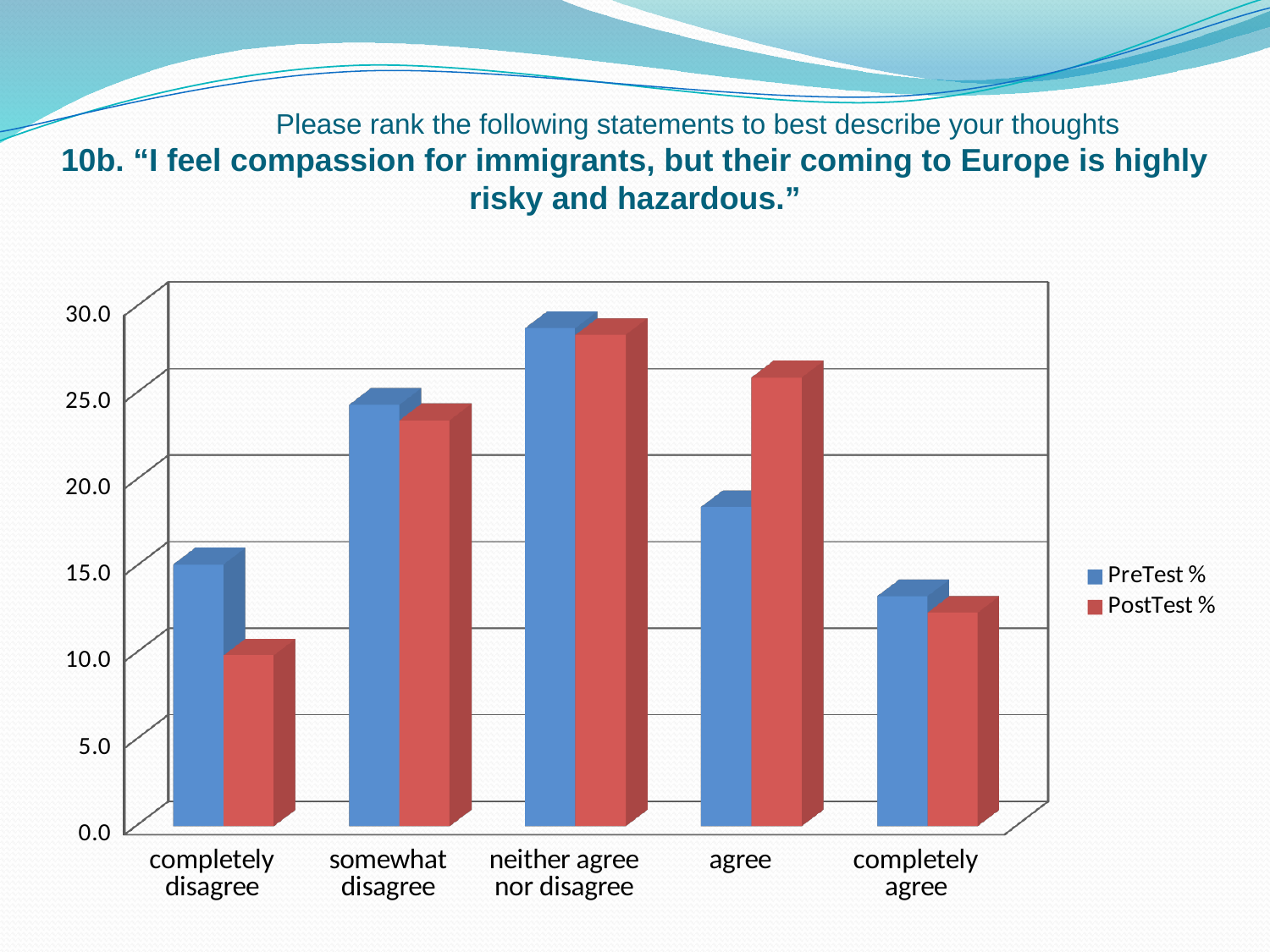
Is the PostTest % value for 'agree' greater or less than 20.0? greater Which category has the highest PreTest % value? neither agree nor disagree Is the PostTest % value for 'completely agree' greater or less than 15.0? less Is the PreTest % value for 'completely disagree' greater or less than 20.0? less What kind of chart is shown on the slide? bar chart Which category has the lowest PostTest % value? completely disagree For the 'agree' category, which is larger: PreTest % or PostTest %? PostTest % How many response categories are shown on the x axis? 5 Which colour represents the PostTest % series in the legend? red How many series does the legend list? 2 For the 'completely disagree' category, which is larger: PreTest % or PostTest %? PreTest %